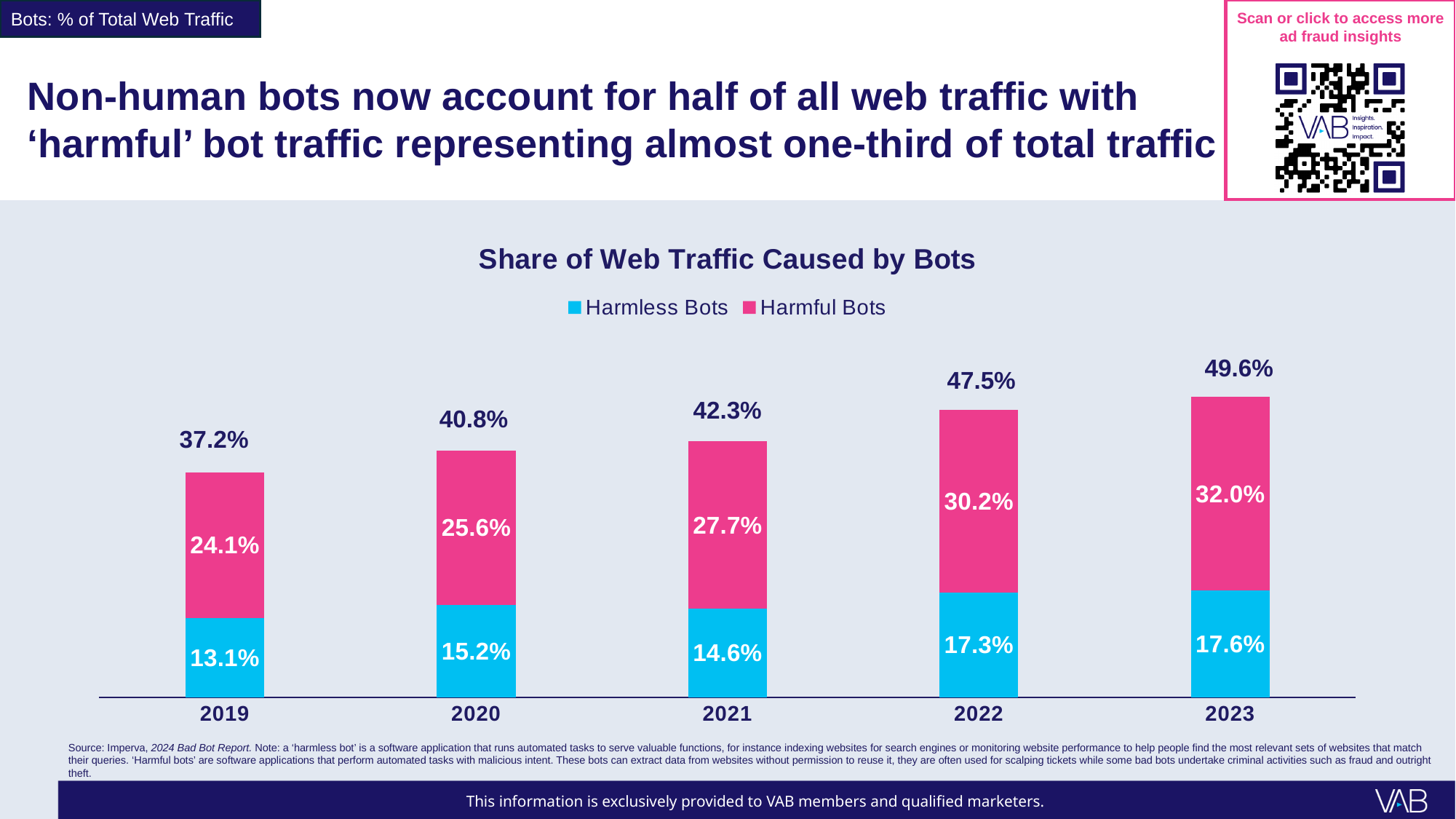
Which is larger, the Harmless Bots value for 2020 or for 2021? 2020 What is the total share of web traffic caused by bots in 2022? 47.5% How many series does the legend list? 2 What is the value for Harmless Bots in 2019? 13.1% Which year has the lowest value for Harmless Bots? 2019 Which year has the highest total share of web traffic caused by bots? 2023 Do the total bot traffic shares rise or fall from 2019 to 2023? Rise What is the value for Harmful Bots in 2023? 32.0% What is the difference between the Harmful Bots values for 2023 and 2019? 7.9% What is the value for Harmful Bots in 2021? 27.7% How many years are shown on the x axis? 5 What kind of chart is shown? Stacked bar chart